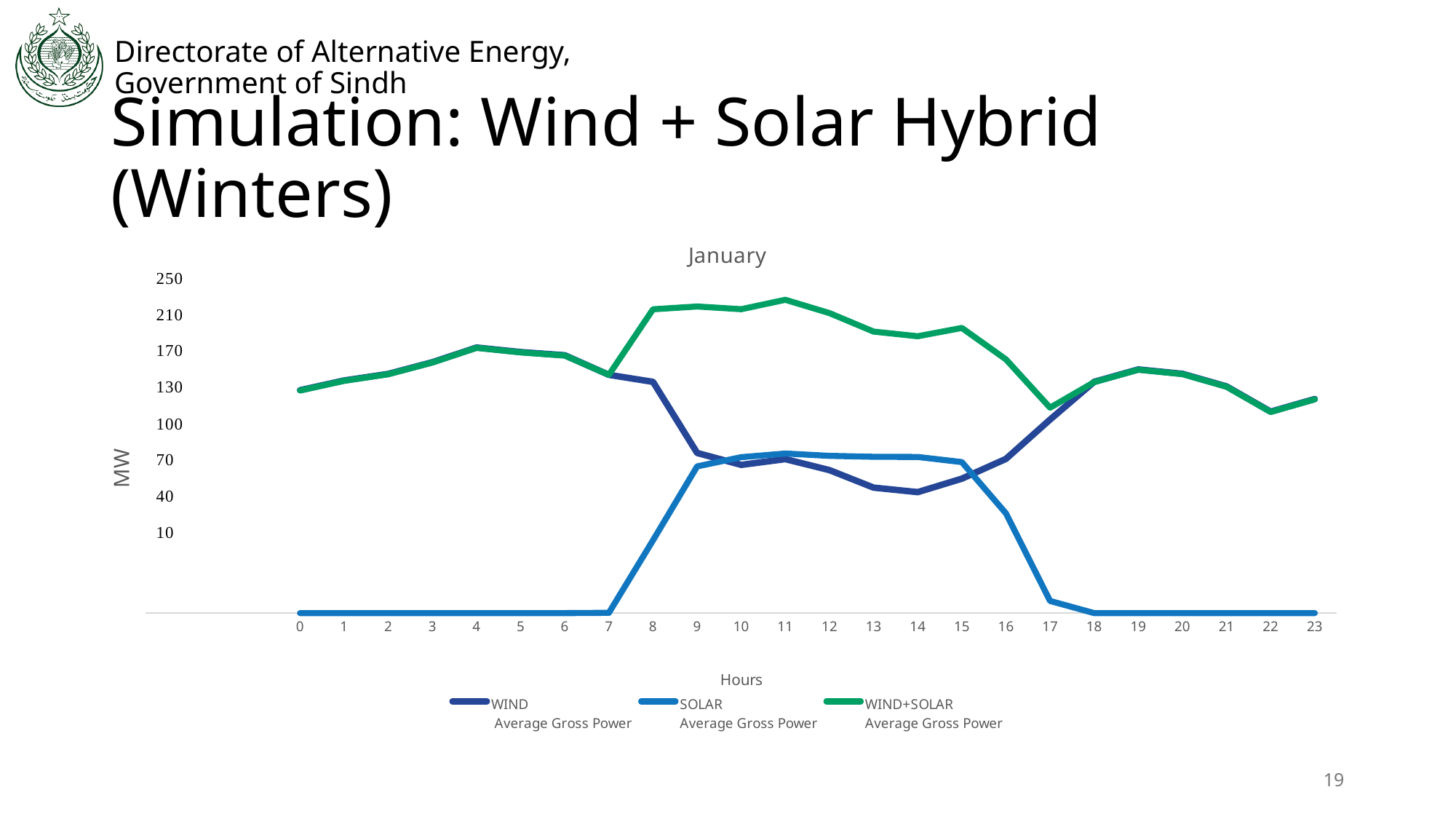
Is the WIND value at hour 14 greater or less than 70? less How many series does the legend list? 3 At hour 8, which is larger, WIND or SOLAR? WIND How many hours are plotted along the x axis? 24 Is the WIND value at hour 8 greater or less than 100? greater Is the WIND+SOLAR value at hour 11 greater or less than 210? greater Which series has the highest value at hour 11? WIND+SOLAR What kind of chart is shown on the slide? Line chart What is the label of the y axis? MW Does the SOLAR series rise or fall between hour 7 and hour 11? Rise What is the title of the chart? January